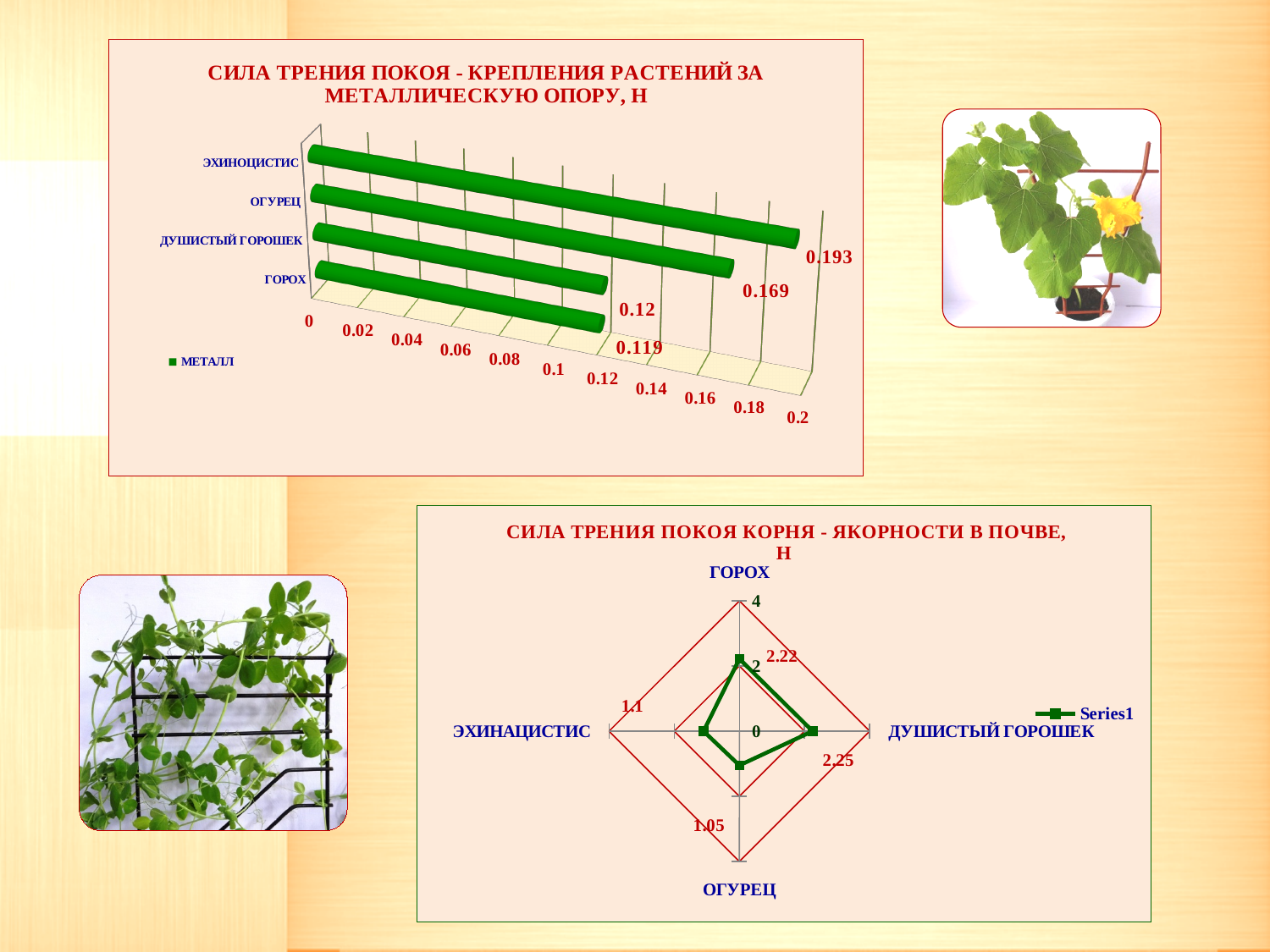
In the top chart, how many categories are plotted? 4 In the bottom chart, which is larger: the value for ГОРОХ or the value for ЭХИНАЦИСТИС? ГОРОХ What type of chart is the top chart? bar chart In the top chart, which category has the lowest value? ГОРОХ In the top chart, what is the value for ОГУРЕЦ? 0.169 In the bottom chart, what is the value for ОГУРЕЦ? 1.05 In the top chart, which category has the highest value? ЭХИНОЦИСТИС In the bottom chart (СИЛА ТРЕНИЯ ПОКОЯ КОРНЯ - ЯКОРНОСТИ В ПОЧВЕ, Н), what is the value for ДУШИСТЫЙ ГОРОШЕК? 2.25 In the top chart (СИЛА ТРЕНИЯ ПОКОЯ - КРЕПЛЕНИЯ РАСТЕНИЙ ЗА МЕТАЛЛИЧЕСКУЮ ОПОРУ, Н), what is the value for ЭХИНОЦИСТИС? 0.193 What is the legend entry of the top chart? МЕТАЛЛ What type of chart is the bottom chart? radar chart In the top chart, what is the difference between the values for ЭХИНОЦИСТИС and ОГУРЕЦ? 0.024